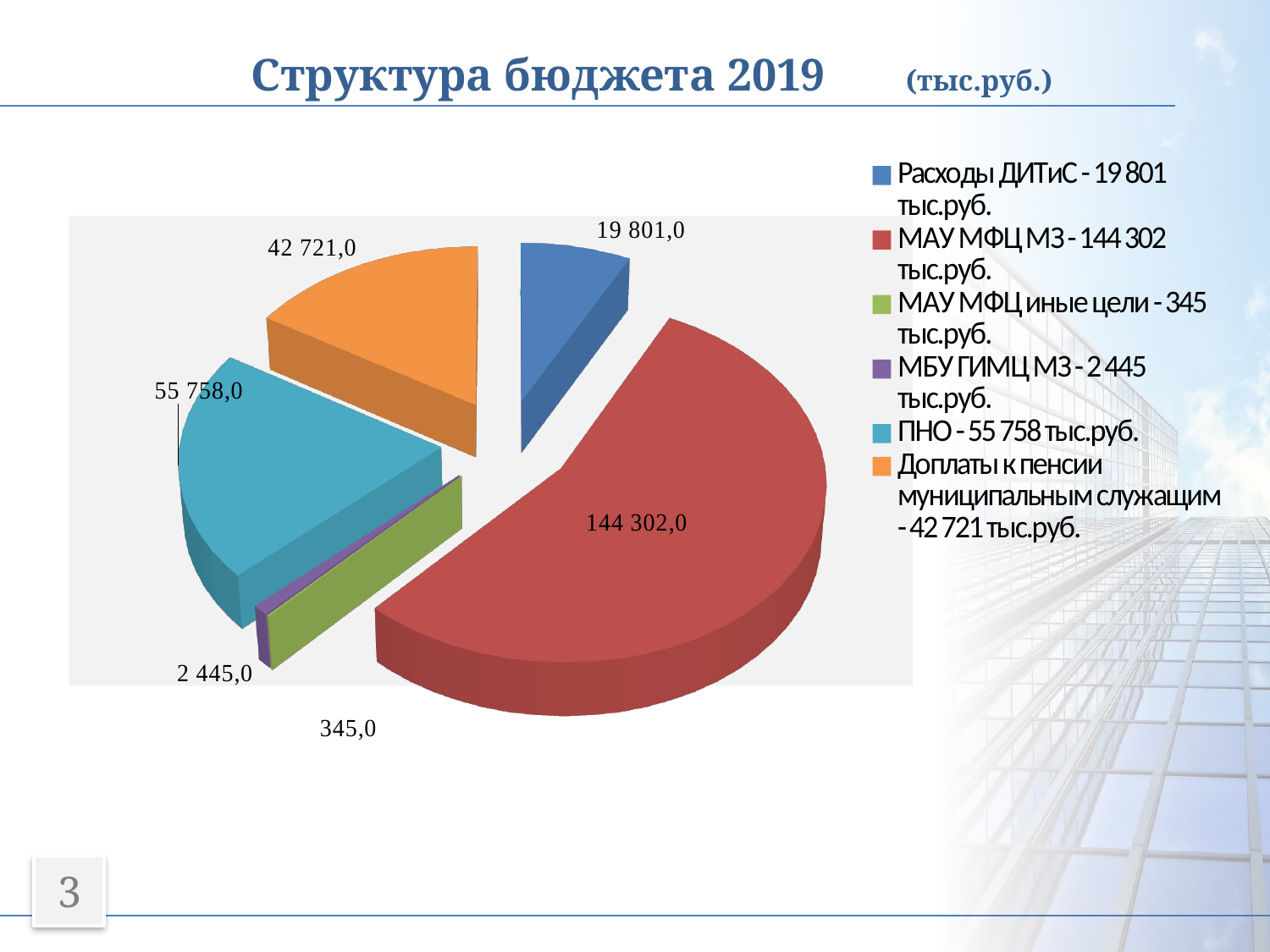
What is the value of the slice for МАУ МФЦ МЗ? 144 302,0 What is the value of the slice for Расходы ДИТиС? 19 801,0 Which category has the largest slice of the pie? МАУ МФЦ МЗ What is the value of the slice for Доплаты к пенсии муниципальным служащим? 42 721,0 What is the title of the slide containing the chart? Структура бюджета 2019 (тыс.руб.) What is the difference between the values for МАУ МФЦ МЗ and ПНО? 88 544,0 What type of chart is shown on the slide? Pie chart What is the value of the slice for ПНО? 55 758,0 Which category has the smallest slice of the pie? МАУ МФЦ иные цели How many slices does the pie chart have? 6 How many entries does the legend list? 6 Which is larger, the value for ПНО or the value for Доплаты к пенсии муниципальным служащим? ПНО